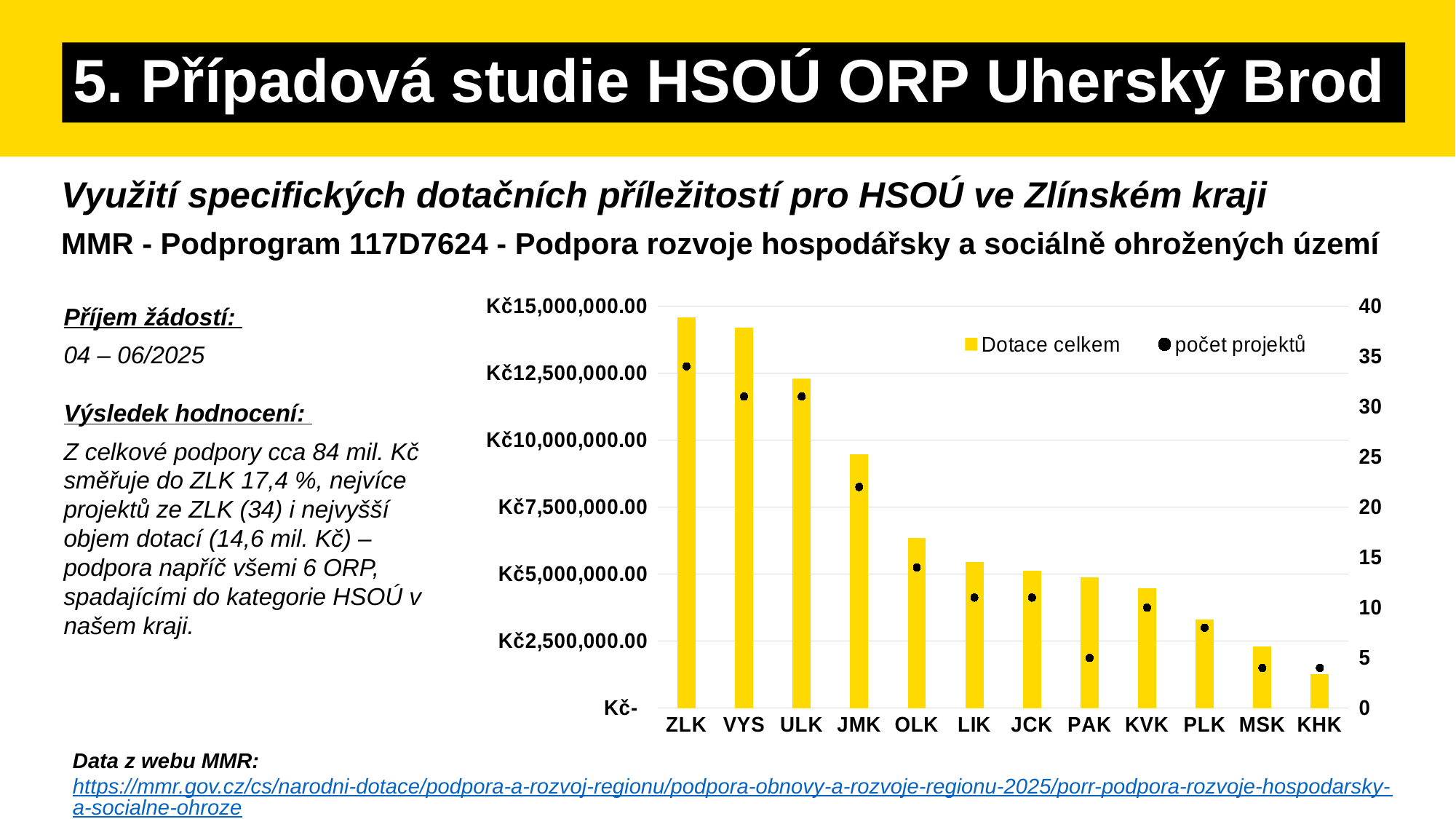
How many regions (categories) are shown on the x axis of the chart? 12 Which region has the lowest Dotace celkem bar? KHK Do the Dotace celkem bars rise or fall from left to right along the x axis? fall Is the Dotace celkem value for JMK greater or less than Kč7,500,000.00? greater Which has a larger Dotace celkem bar, ULK or JMK? ULK Is the Dotace celkem value for KHK greater or less than Kč2,500,000.00? less Which region has the highest Dotace celkem bar? ZLK Is the počet projektů value for PAK greater or less than 10? less How many series does the chart legend list? 2 What kind of chart is shown on the slide? combination chart: bars (Dotace celkem) with a dot-marker series (počet projektů)